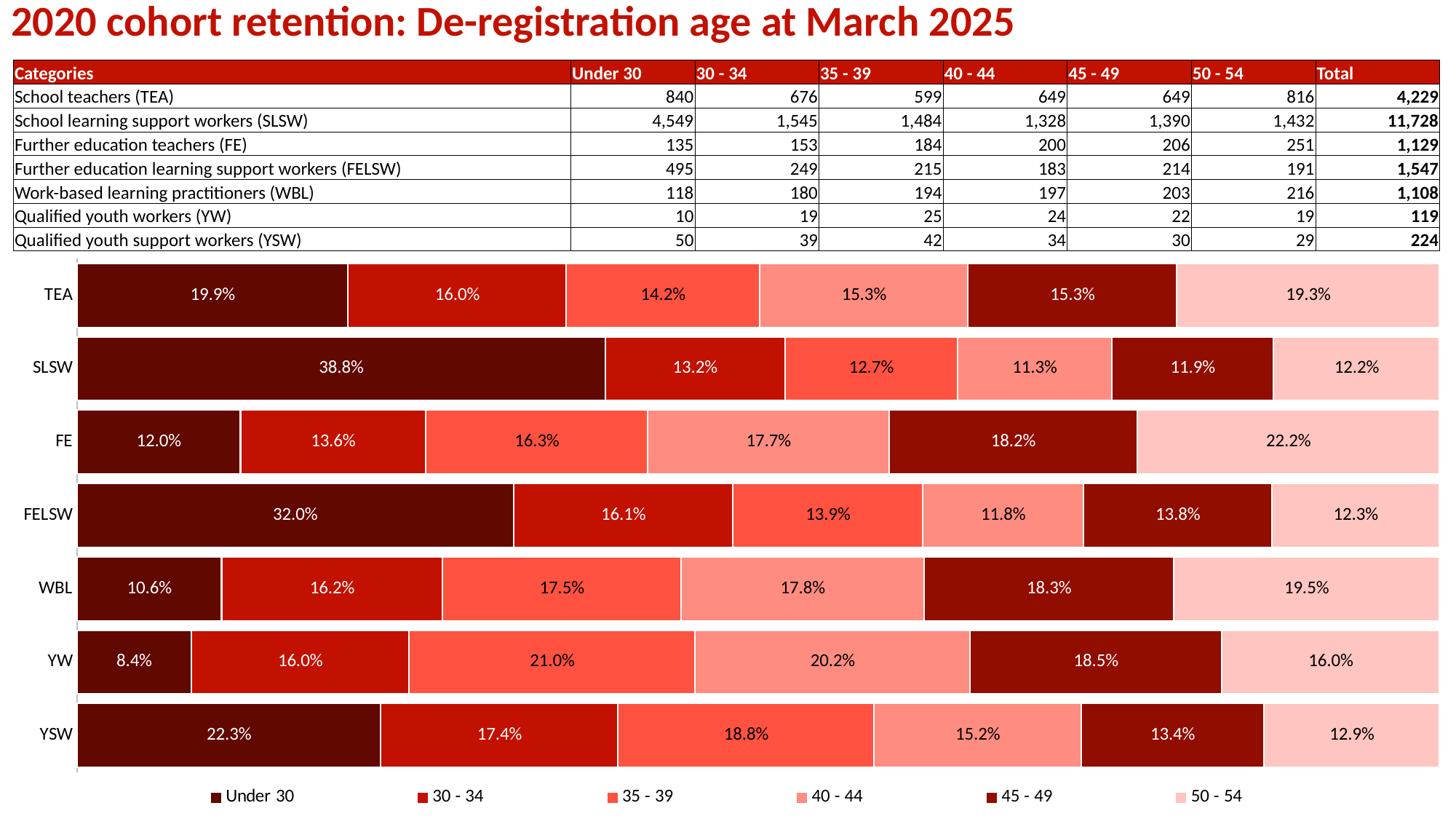
In the bar chart, what is the difference between the Under 30 share and the 30 - 34 share for FELSW? 15.9 percentage points In the bar chart, what is the Under 30 share for SLSW? 38.8% In the bar chart, what is the 50 - 54 share for FE? 22.2% How many series does the chart legend list? 6 In the bar chart, what is the 35 - 39 share for YW? 21.0% What kind of chart is shown below the table? bar chart What is the first entry in the chart legend? Under 30 In the bar chart, which is larger: the 50 - 54 share for FE or the 50 - 54 share for YSW? FE Which category has the largest Under 30 share in the bar chart? SLSW In the bar chart, which is larger: the Under 30 share for YSW or the Under 30 share for WBL? YSW Which category has the smallest Under 30 share in the bar chart? YW How many categories are plotted in the bar chart? 7